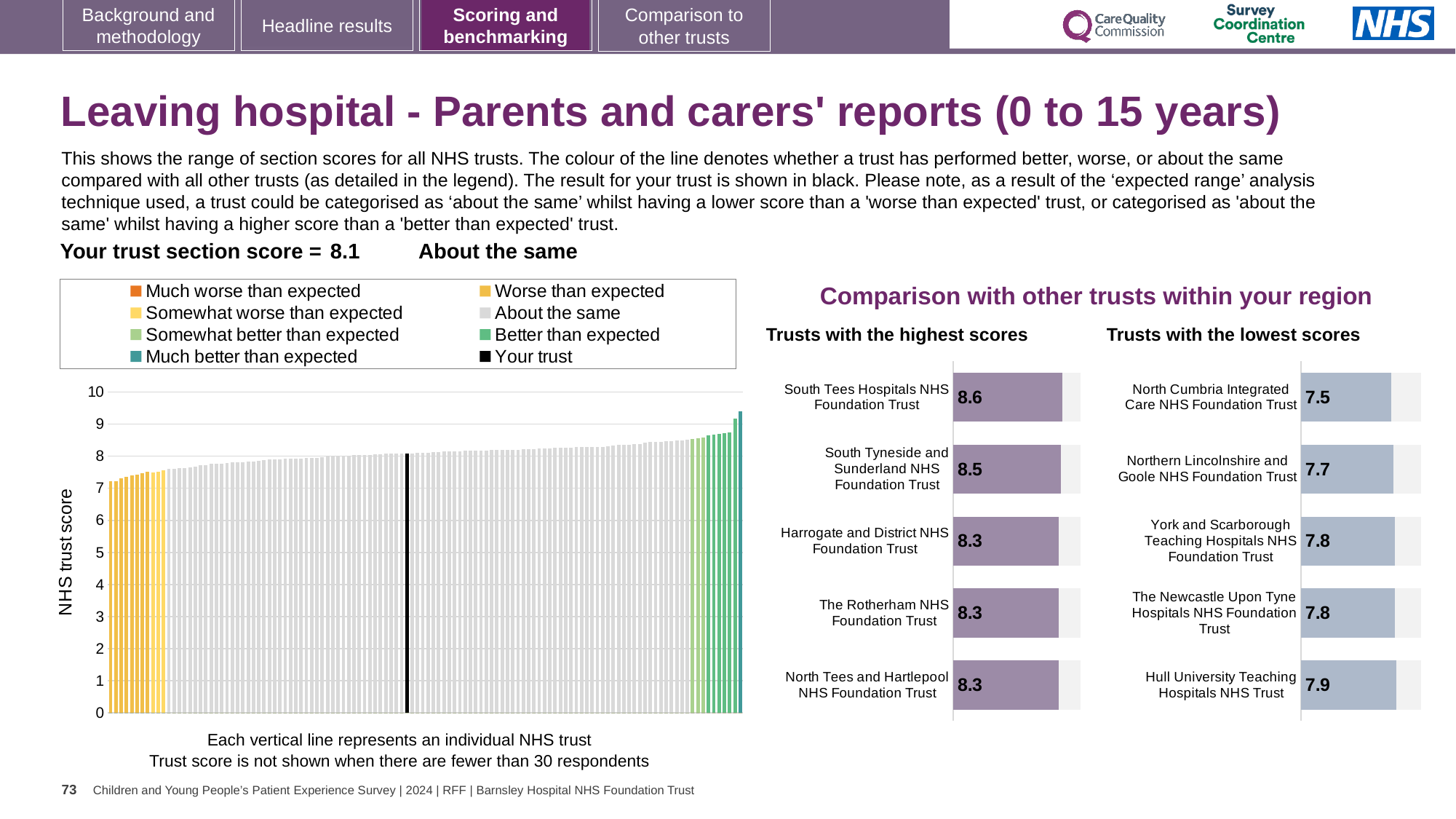
In the 'Trusts with the lowest scores' chart, which trust has the lowest score? North Cumbria Integrated Care NHS Foundation Trust In the 'Trusts with the lowest scores' chart, what is the difference between the scores of Hull University Teaching Hospitals NHS Trust and North Cumbria Integrated Care NHS Foundation Trust? 0.4 In the 'Trusts with the lowest scores' chart, what is the score for North Cumbria Integrated Care NHS Foundation Trust? 7.5 In the 'Trusts with the highest scores' chart, what is the score for South Tyneside and Sunderland NHS Foundation Trust? 8.5 In the 'Trusts with the highest scores' chart, which trust has the highest score? South Tees Hospitals NHS Foundation Trust Comparing the two regional charts, what is the difference between the score of South Tees Hospitals NHS Foundation Trust and North Cumbria Integrated Care NHS Foundation Trust? 1.1 In the large 'NHS trust score' chart, do the trust scores rise or fall from left to right? rise In the 'Trusts with the lowest scores' chart, what is the score for Hull University Teaching Hospitals NHS Trust? 7.9 In the 'Trusts with the highest scores' chart, what is the score for South Tees Hospitals NHS Foundation Trust? 8.6 In the 'Trusts with the lowest scores' chart, which has the larger score: Northern Lincolnshire and Goole NHS Foundation Trust or Hull University Teaching Hospitals NHS Trust? Hull University Teaching Hospitals NHS Trust How many entries does the legend of the large 'NHS trust score' chart list? 8 How many trusts are shown in the 'Trusts with the highest scores' chart? 5